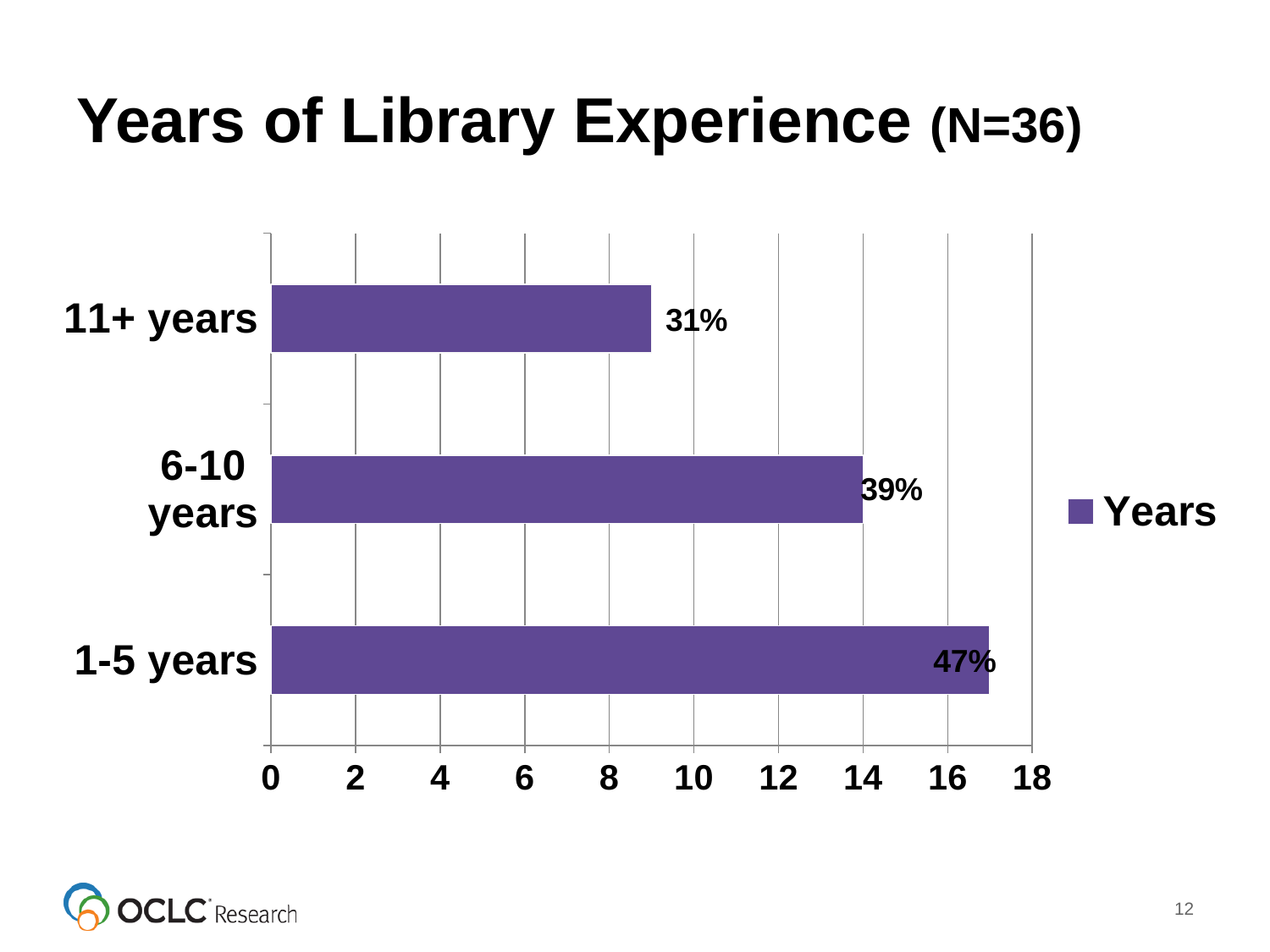
What is the difference in percentage points between the 1-5 years and 6-10 years labels? 8% Which category has the highest value? 1-5 years What is the data label shown for the 11+ years bar? 31% How many categories are shown in the chart? 3 Is the bar for 1-5 years greater or less than 16 on the axis? greater Is the bar for 11+ years greater or less than 10 on the axis? less What is the data label shown for the 6-10 years bar? 39% What kind of chart is shown on the slide? bar chart What is the difference in percentage points between the 1-5 years and 11+ years labels? 16% Which category has the lowest value? 11+ years What is the data label shown for the 1-5 years bar? 47% Which is larger, the value for 6-10 years or the value for 11+ years? 6-10 years